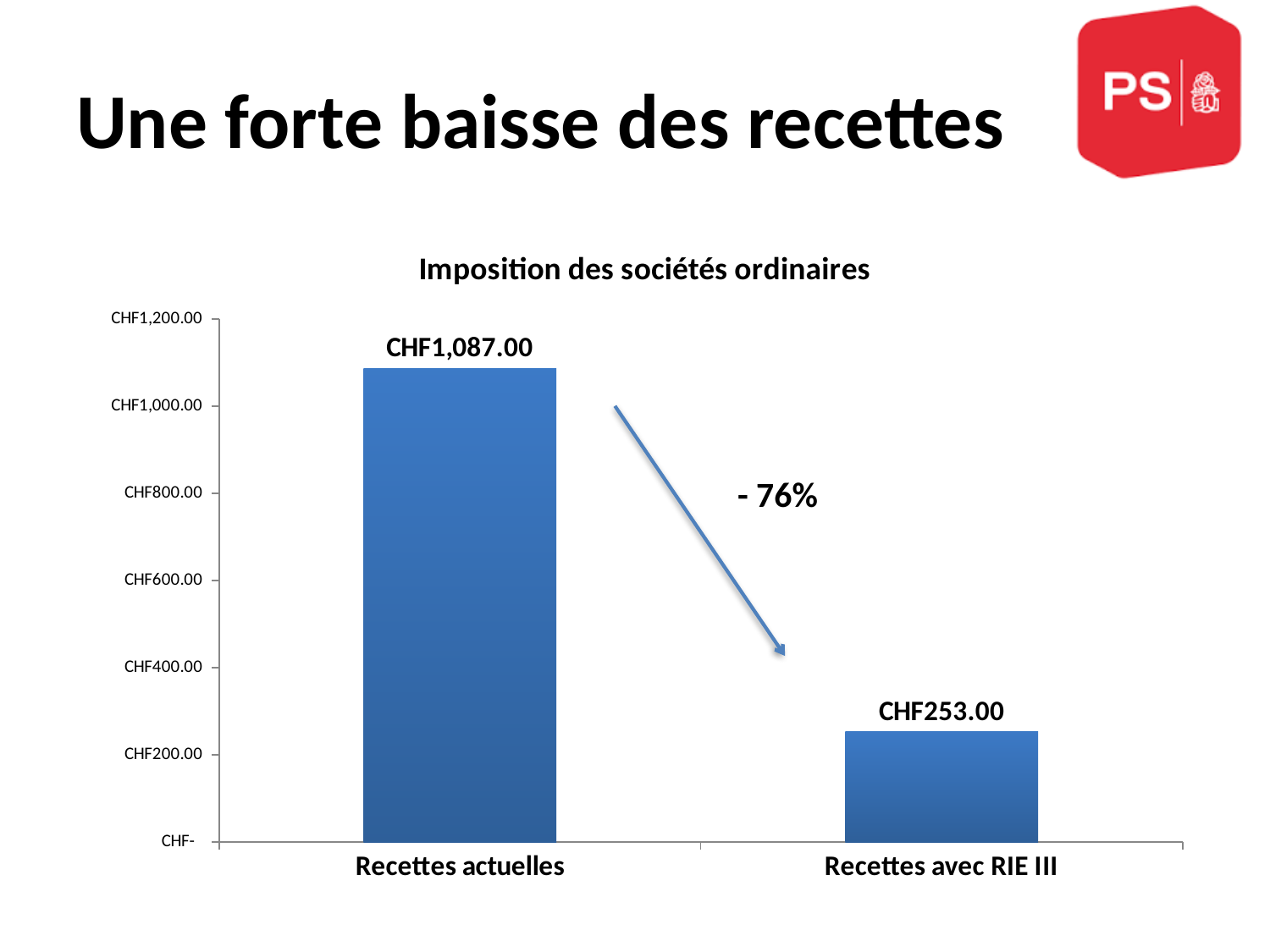
What is the title of the chart? Imposition des sociétés ordinaires What kind of chart is shown on the slide? bar chart Which category has the lowest value? Recettes avec RIE III How many categories are shown on the chart? 2 Is the value for Recettes actuelles greater or less than CHF1,000.00? greater Which is larger, the value for Recettes actuelles or the value for Recettes avec RIE III? Recettes actuelles Do the values rise or fall from Recettes actuelles to Recettes avec RIE III? fall What is the value for Recettes actuelles? CHF1,087.00 Which category has the highest value? Recettes actuelles What is the value for Recettes avec RIE III? CHF253.00 Is the value for Recettes avec RIE III greater or less than CHF400.00? less What is the difference between the values for Recettes actuelles and Recettes avec RIE III? CHF834.00